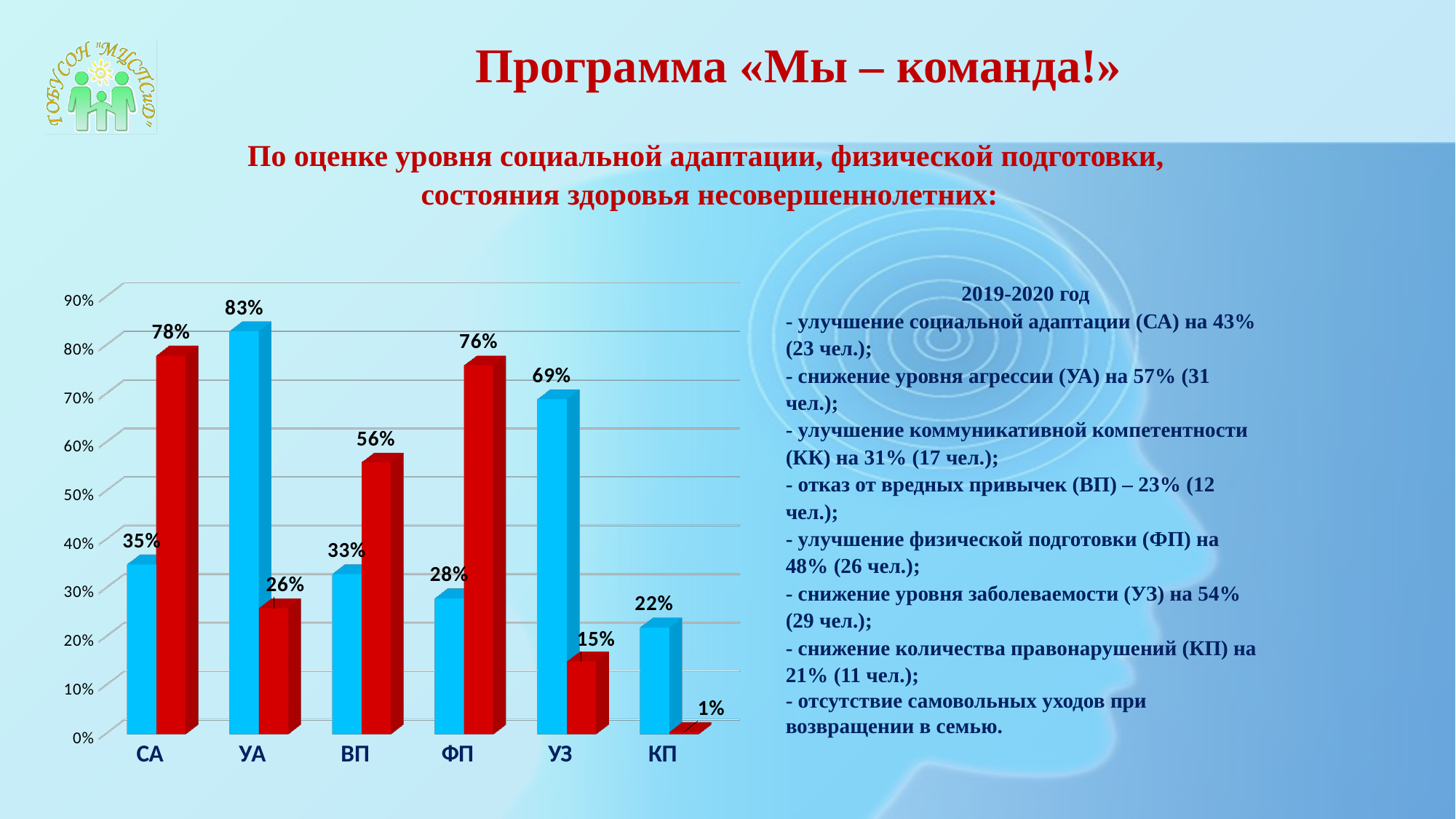
What is the highest value shown on the vertical axis? 90% What is the value of the blue bar for СА? 35% What is the difference between the blue bar and the red bar for УА? 57% Which category has the lowest red bar? КП How many categories are shown on the x axis? 6 Which is larger for ВП, the blue bar or the red bar? the red bar What kind of chart is shown on the slide? bar chart What is the difference between the red bar and the blue bar for СА? 43% Is the value of the blue bar for УЗ greater or less than 60%? greater What is the value of the red bar for КП? 1% What is the value of the red bar for ФП? 76% Which category has the highest blue bar? УА